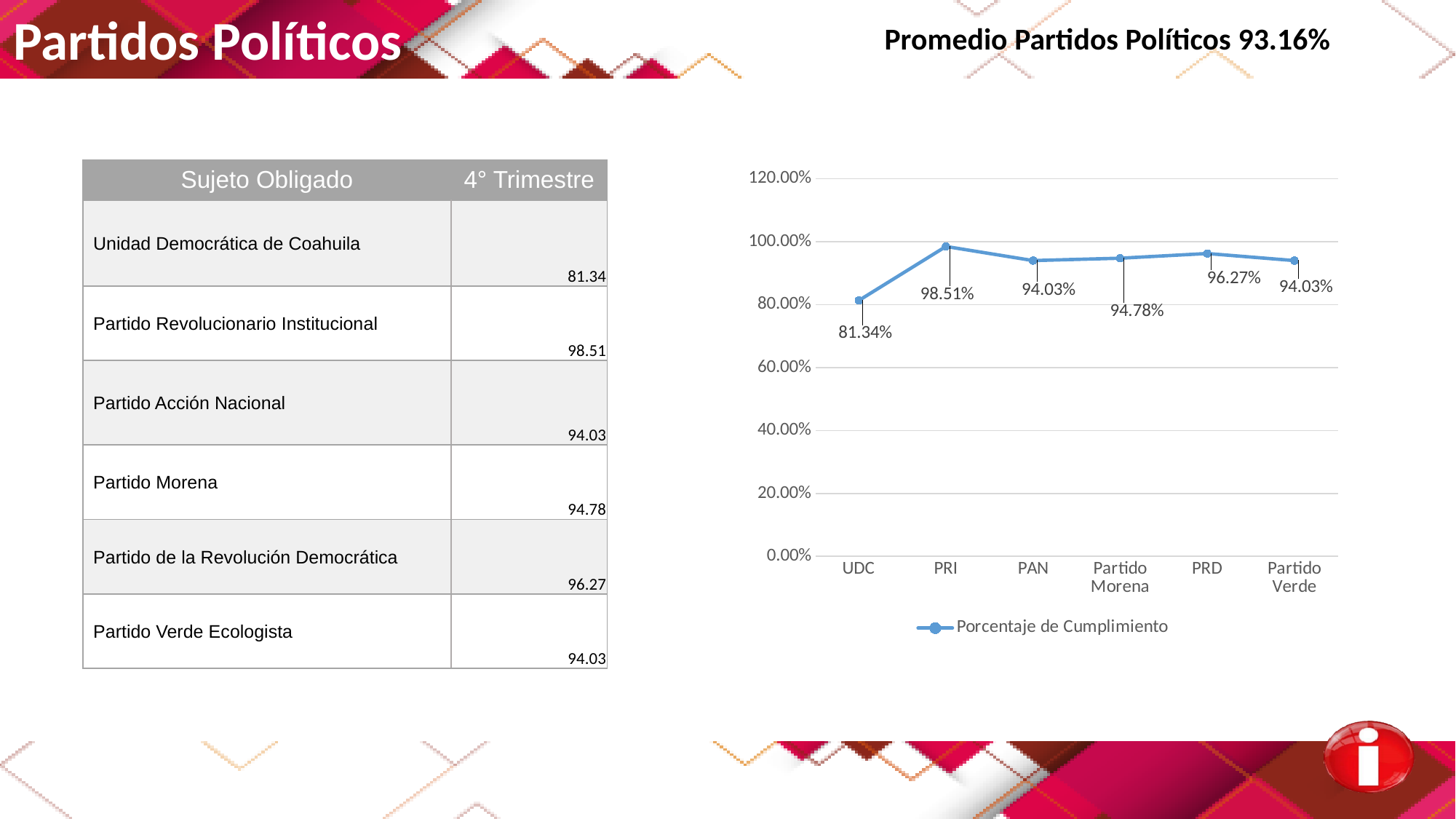
Which category has the highest value in the chart? PRI What is the value for Partido Morena in the chart? 94.78% What kind of chart is shown on the slide? line chart Which category has the lowest value in the chart? UDC What is the value for UDC in the chart? 81.34% How many categories are plotted on the x axis of the chart? 6 What series name does the chart legend show? Porcentaje de Cumplimiento What is the value for PRD in the chart? 96.27% What is the difference between the values for PRI and UDC? 17.17% Which is larger, the value for PRD or the value for Partido Morena? PRD Is the value for UDC greater or less than 100.00%? less What is the value for PRI in the chart? 98.51%